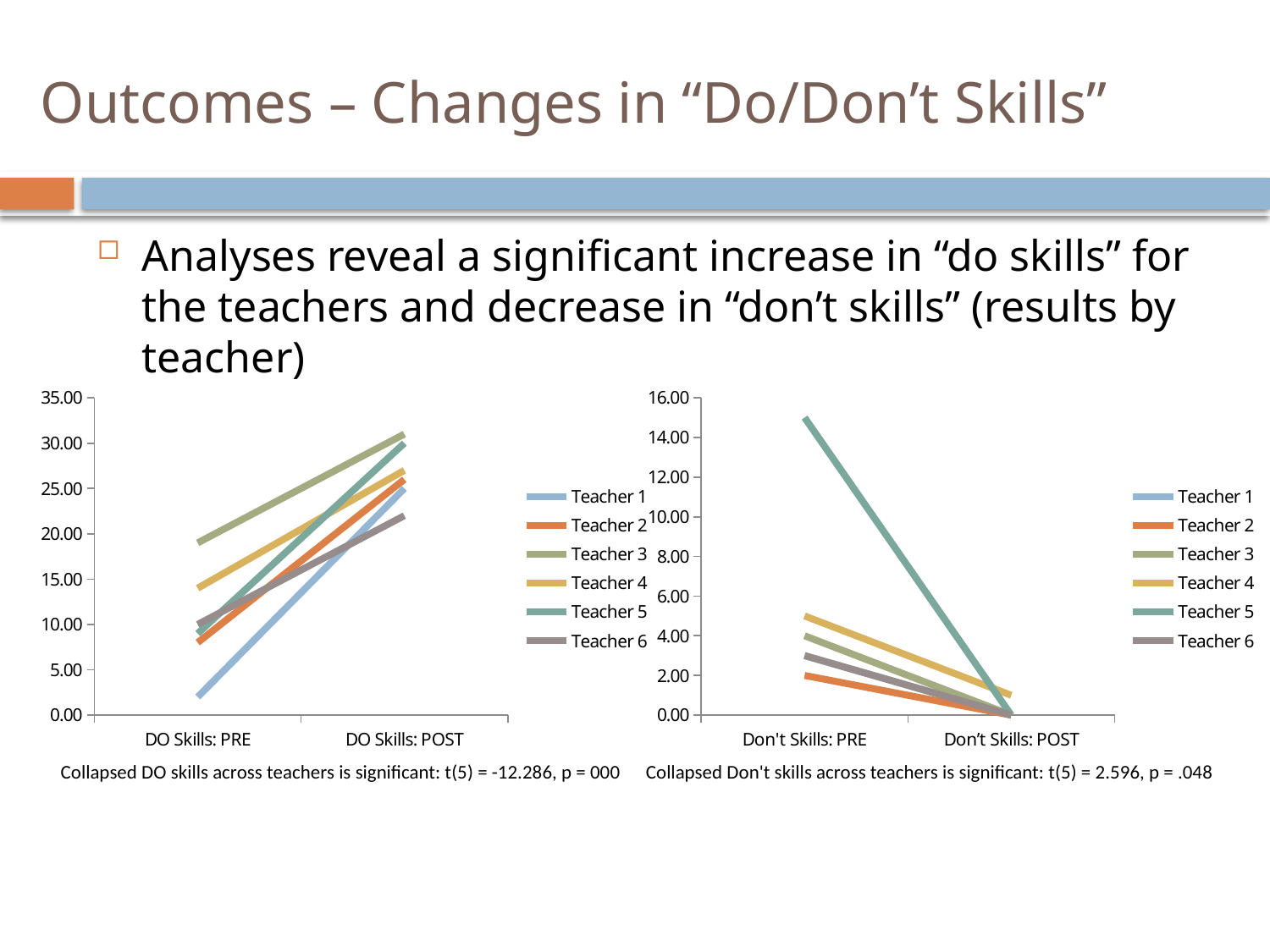
What kind of chart is the left chart (DO Skills)? line chart In the right chart (Don't Skills), is the value for Teacher 5 at Don't Skills: PRE greater or less than 12.00? greater In the left chart (DO Skills), which teacher has the lowest value at DO Skills: PRE? Teacher 1 In the right chart (Don't Skills), do the teachers' values rise or fall from Don't Skills: PRE to Don't Skills: POST? fall What are the two x-axis category labels on the right chart? Don't Skills: PRE and Don't Skills: POST In the left chart (DO Skills), which is larger at DO Skills: PRE, the value for Teacher 3 or the value for Teacher 1? Teacher 3 In the right chart (Don't Skills), which teacher has the highest value at Don't Skills: PRE? Teacher 5 How many series does the legend of the left chart (DO Skills) list? 6 In the left chart (DO Skills), is the value for Teacher 1 at DO Skills: PRE greater or less than 5.00? less In the left chart (DO Skills), do the teachers' values rise or fall from DO Skills: PRE to DO Skills: POST? rise How many categories are shown on the x axis of the right chart (Don't Skills)? 2 In the left chart (DO Skills), which teacher has the highest value at DO Skills: PRE? Teacher 3